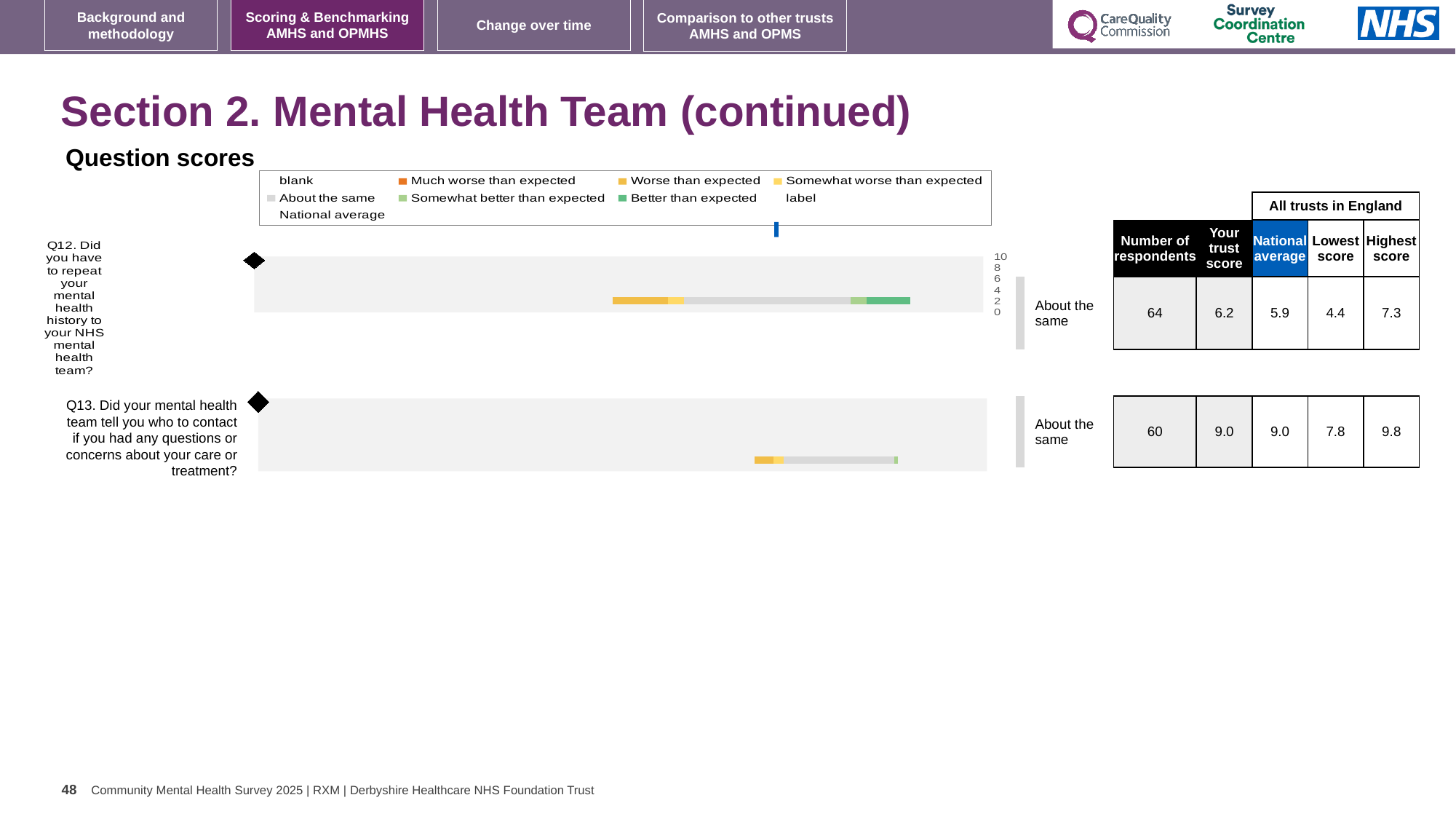
What is the trust score for Q12 shown in the table beside the chart? 6.2 According to the table beside the chart, how many respondents answered Q12? 64 What benchmark category is shown next to the Q12 bar? About the same For Q12, what is the difference between the highest score and the lowest score across all trusts in England? 2.9 What kind of chart is used to show the question scores on this slide? bar chart For Q12, which is larger: the trust score or the national average? the trust score (6.2) What is the national average for Q13 shown in the table beside the chart? 9.0 In the chart legend, what colour represents 'Better than expected'? green Which question has the higher trust score, Q12 or Q13? Q13 In the chart legend, which category is shown in orange? Much worse than expected What is the highest score across all trusts in England for Q13? 9.8 How many questions (categories) are plotted in the question scores chart? 2